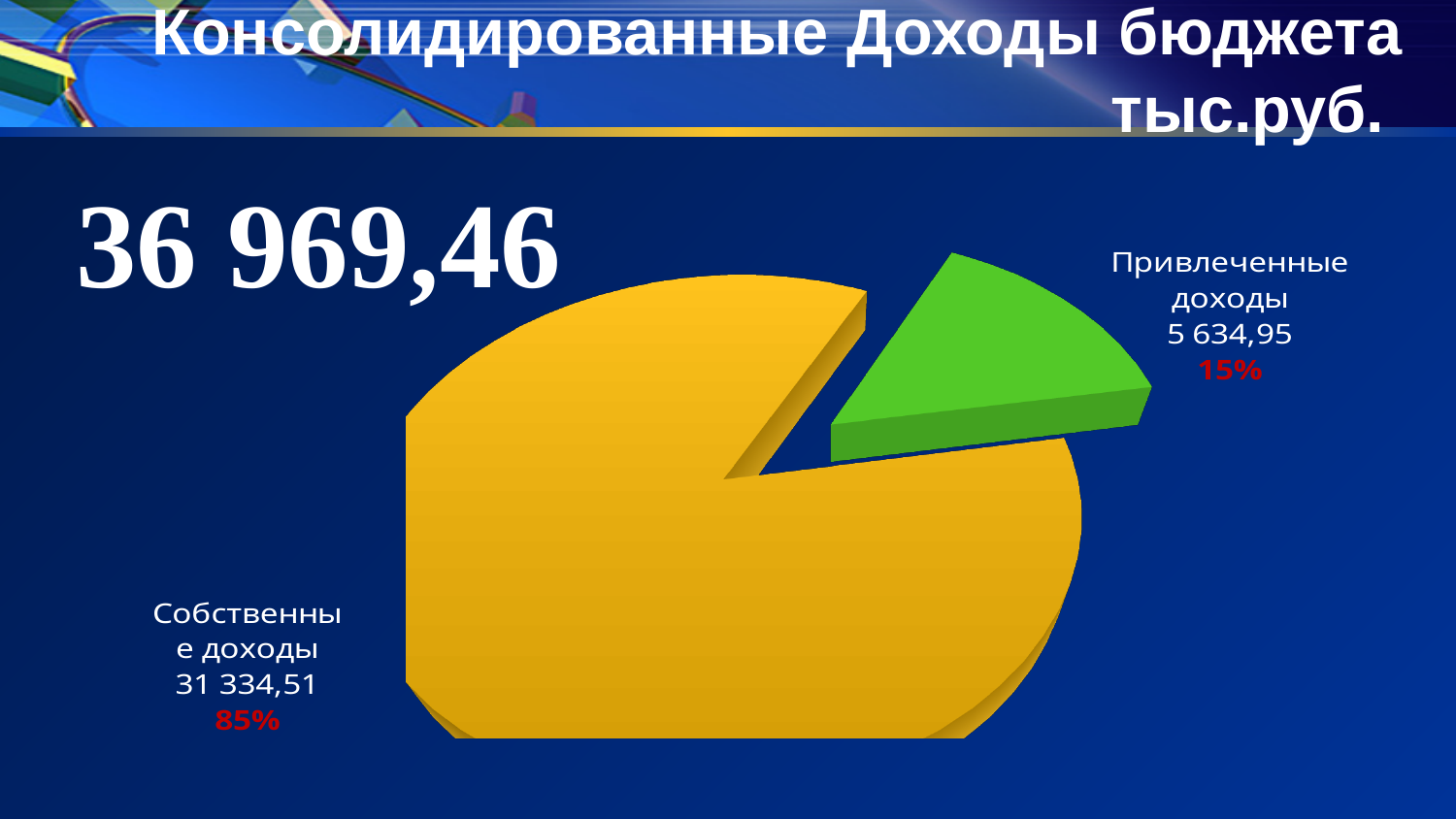
What type of chart is shown on the slide? Pie chart Which category has the largest slice of the pie? Собственные доходы What share of the pie does Собственные доходы represent? 85% How many slices does the pie chart have? 2 Which category has the smallest slice of the pie? Привлеченные доходы What is the value for Привлеченные доходы? 5 634,95 What total value is shown on the slide for the consolidated budget revenues? 36 969,46 What is the difference between Собственные доходы and Привлеченные доходы? 25 699,56 What colour is the slice for Привлеченные доходы? Green Which is larger, Собственные доходы or Привлеченные доходы? Собственные доходы What share of the pie does Привлеченные доходы represent? 15% What is the value for Собственные доходы? 31 334,51